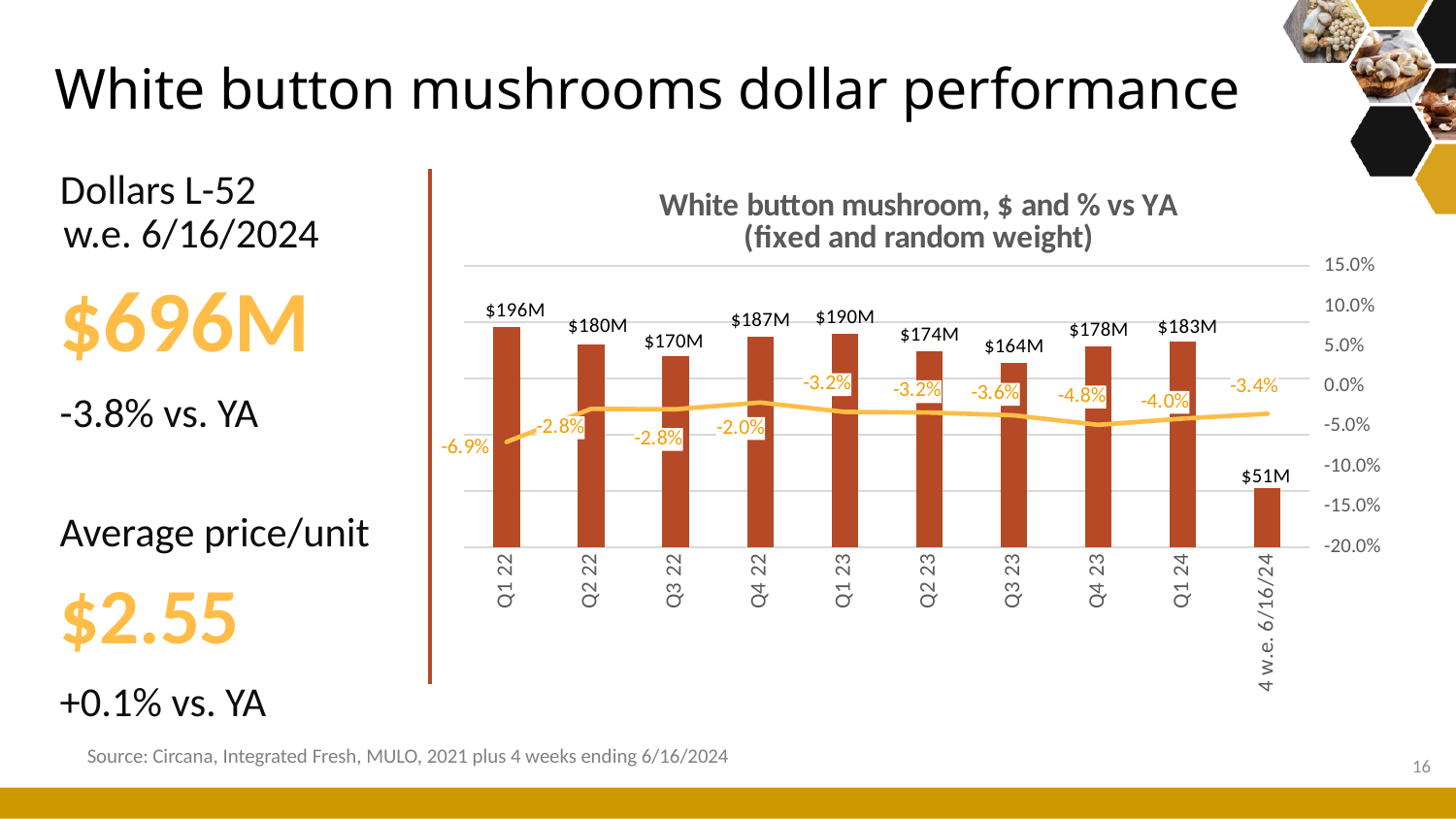
What is the title of the chart? White button mushroom, $ and % vs YA (fixed and random weight) Which has a higher dollar value, Q4 22 or Q1 24? Q4 22 What is the dollar value for the 4 w.e. 6/16/24 period? $51M What type of chart is used to show the dollar values? Bar chart Which period has the lowest % vs YA value? Q1 22 Which period has the lowest dollar value? 4 w.e. 6/16/24 What is the difference in dollar value between Q1 23 and Q2 23? $16M Which quarter has the highest dollar value? Q1 22 What is the dollar value for Q1 22? $196M What is the dollar value for Q3 23? $164M How many periods are shown on the x axis? 10 What is the % vs YA value shown for Q4 23? -4.8%